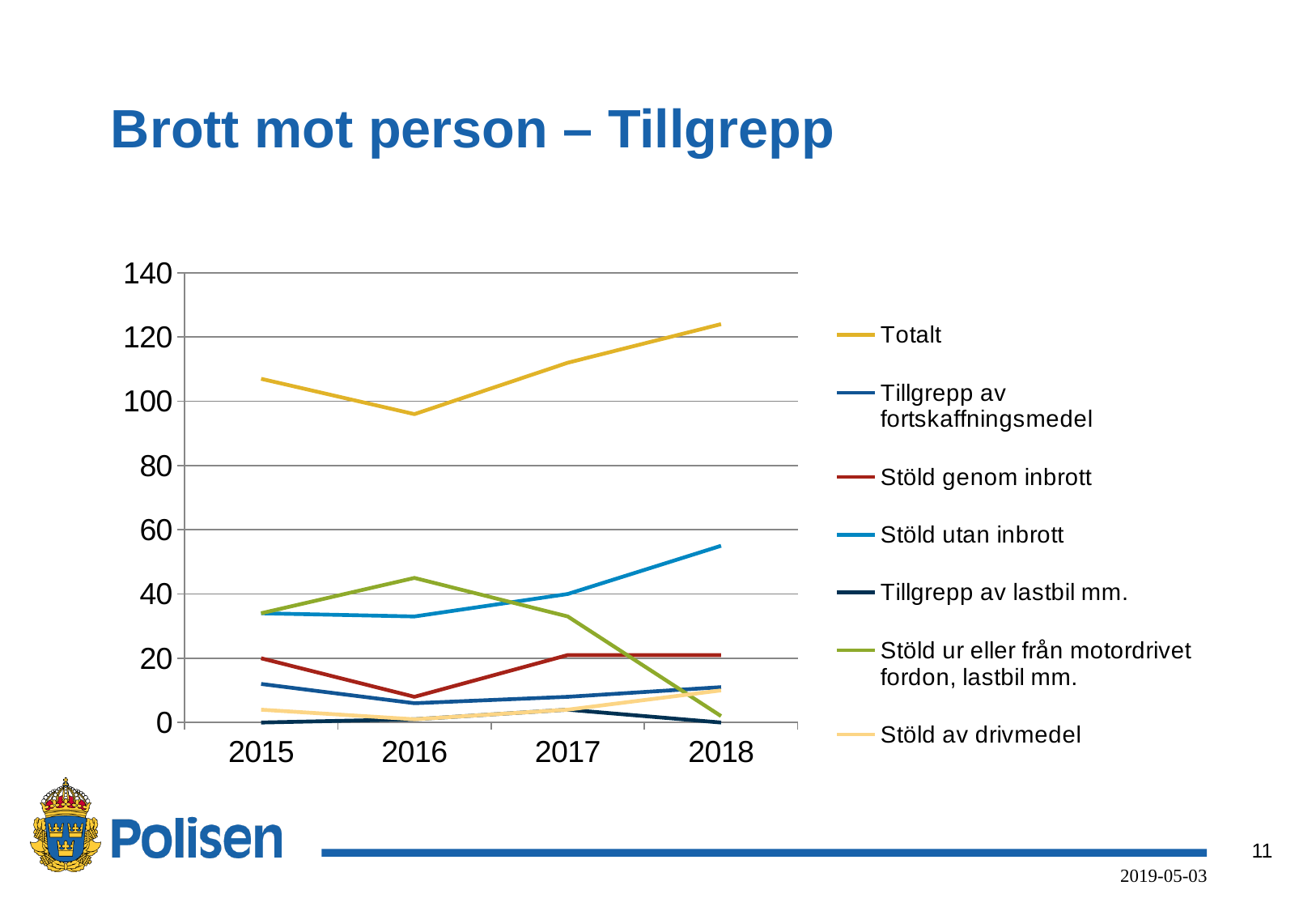
How many years are shown on the x axis? 4 What kind of chart is shown on the slide? Line chart In which year is the Totalt line at its highest? 2018 In 2018, which is larger: Stöld utan inbrott or Stöld genom inbrott? Stöld utan inbrott Is the value for Totalt in 2018 greater or less than 120? greater Is the value for Stöld ur eller från motordrivet fordon, lastbil mm. in 2018 greater or less than 20? less Is the value for Stöld utan inbrott in 2018 greater or less than 40? greater Does the Stöld ur eller från motordrivet fordon, lastbil mm. line rise or fall from 2016 to 2018? fall In which year is the Totalt line at its lowest? 2016 How many series does the legend list? 7 Does the Stöld utan inbrott line rise or fall from 2016 to 2018? rise